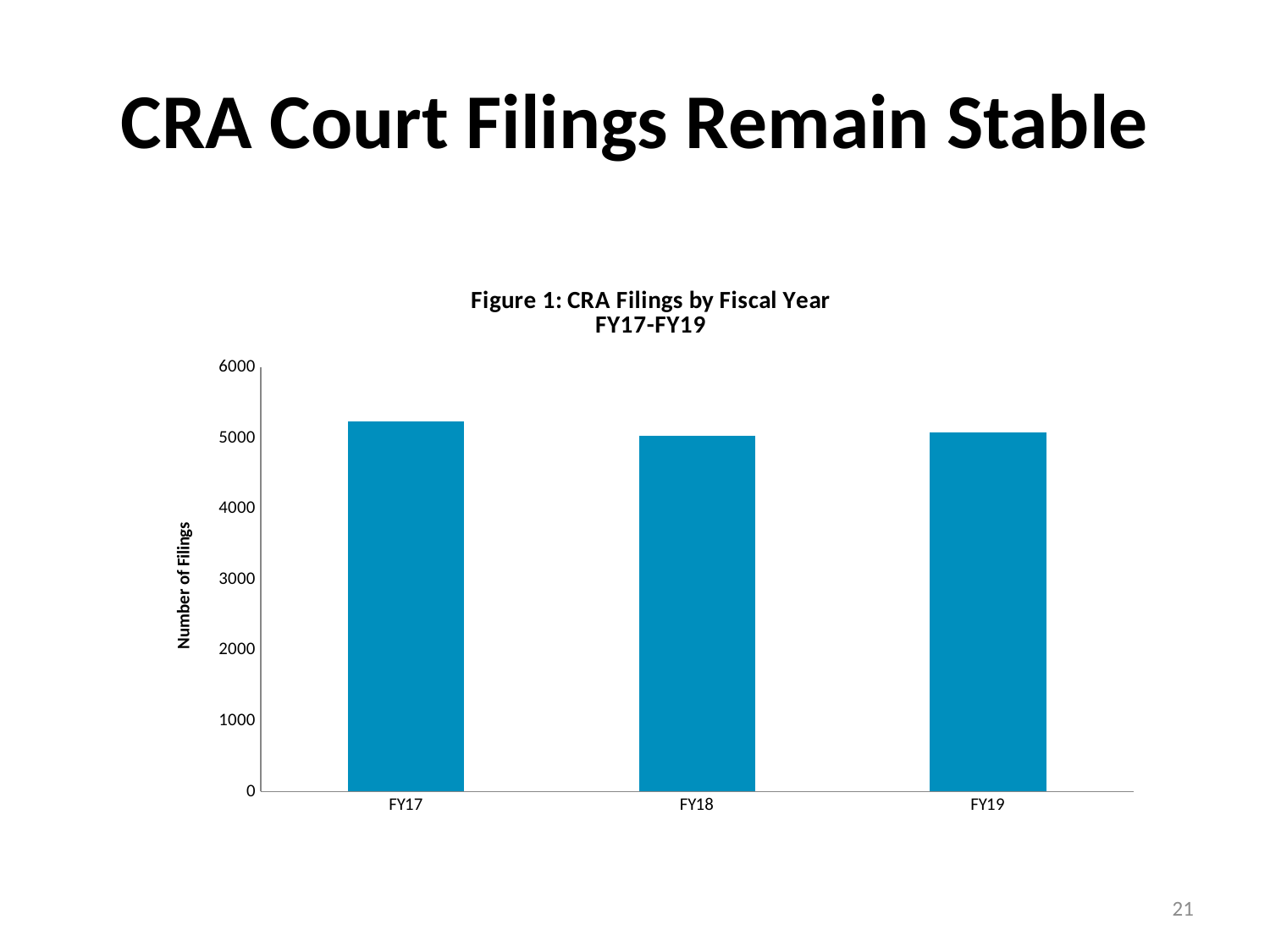
Which fiscal year has the highest number of filings? FY17 Is the value for FY17 greater or less than 5000? greater What type of chart is shown on the slide? Bar chart Is the value for FY17 greater or less than 6000? less What is the label on the vertical axis of the chart? Number of Filings What is the title of the chart? Figure 1: CRA Filings by Fiscal Year FY17-FY19 Is the value for FY18 greater or less than 4000? greater How many fiscal years are plotted in the chart? 3 Which has more filings, FY17 or FY18? FY17